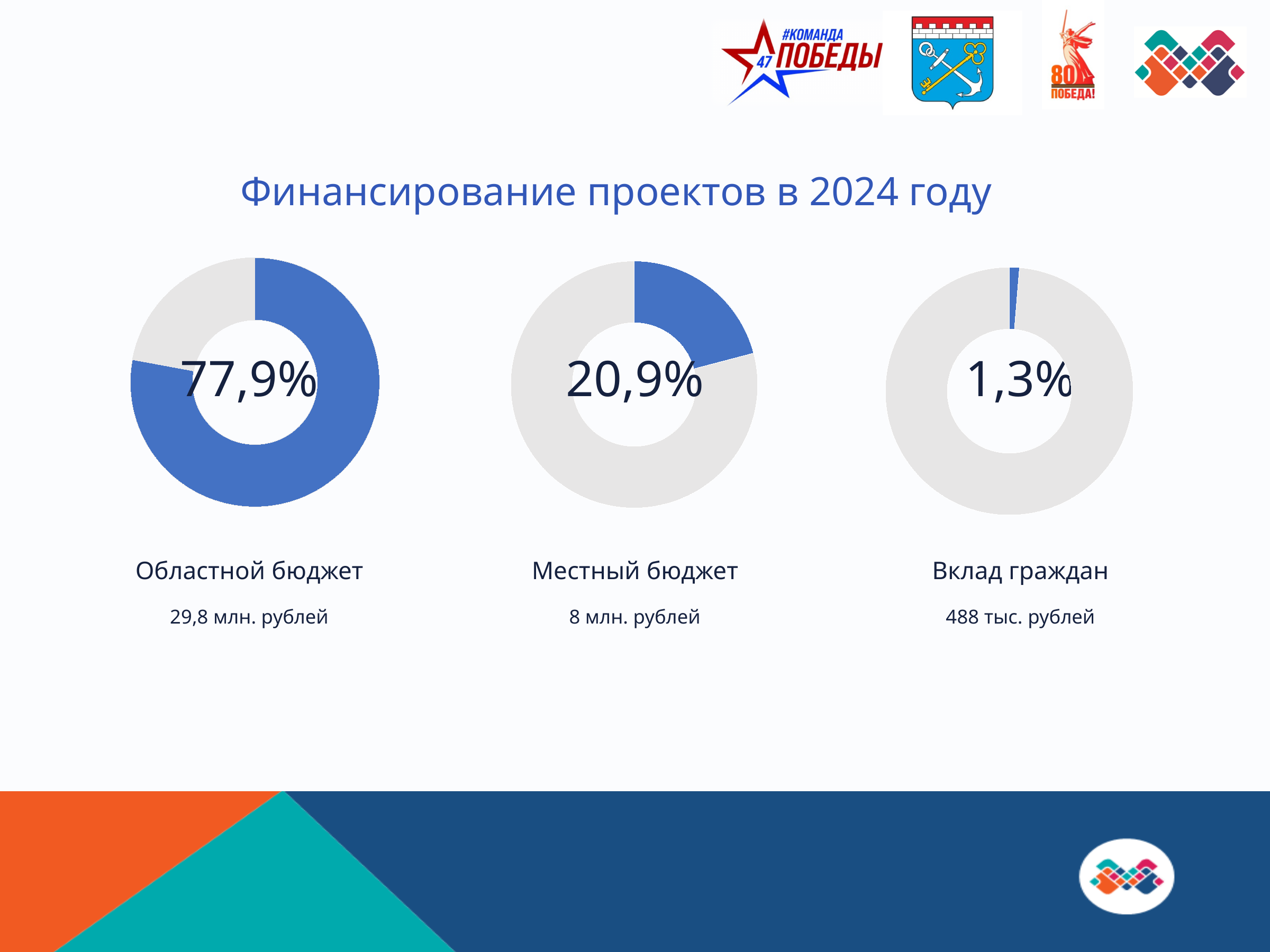
What amount in rubles is given under the Вклад граждан chart? 488 тыс. рублей How many donut charts are shown on the slide? 3 What is the title of the slide above the charts? Финансирование проектов в 2024 году What amount in rubles is given under the Местный бюджет chart? 8 млн. рублей What share is shown in the donut chart for Областной бюджет? 77,9% Which is larger, the share of Местный бюджет or the share of Вклад граждан? Местный бюджет What share is shown in the donut chart for Местный бюджет? 20,9% By how many percentage points does the share of Областной бюджет exceed the share of Местный бюджет? 57,0% What amount in rubles is given under the Областной бюджет chart? 29,8 млн. рублей Which funding source has the largest share? Областной бюджет What share is shown in the donut chart for Вклад граждан? 1,3% Which funding source has the smallest share? Вклад граждан